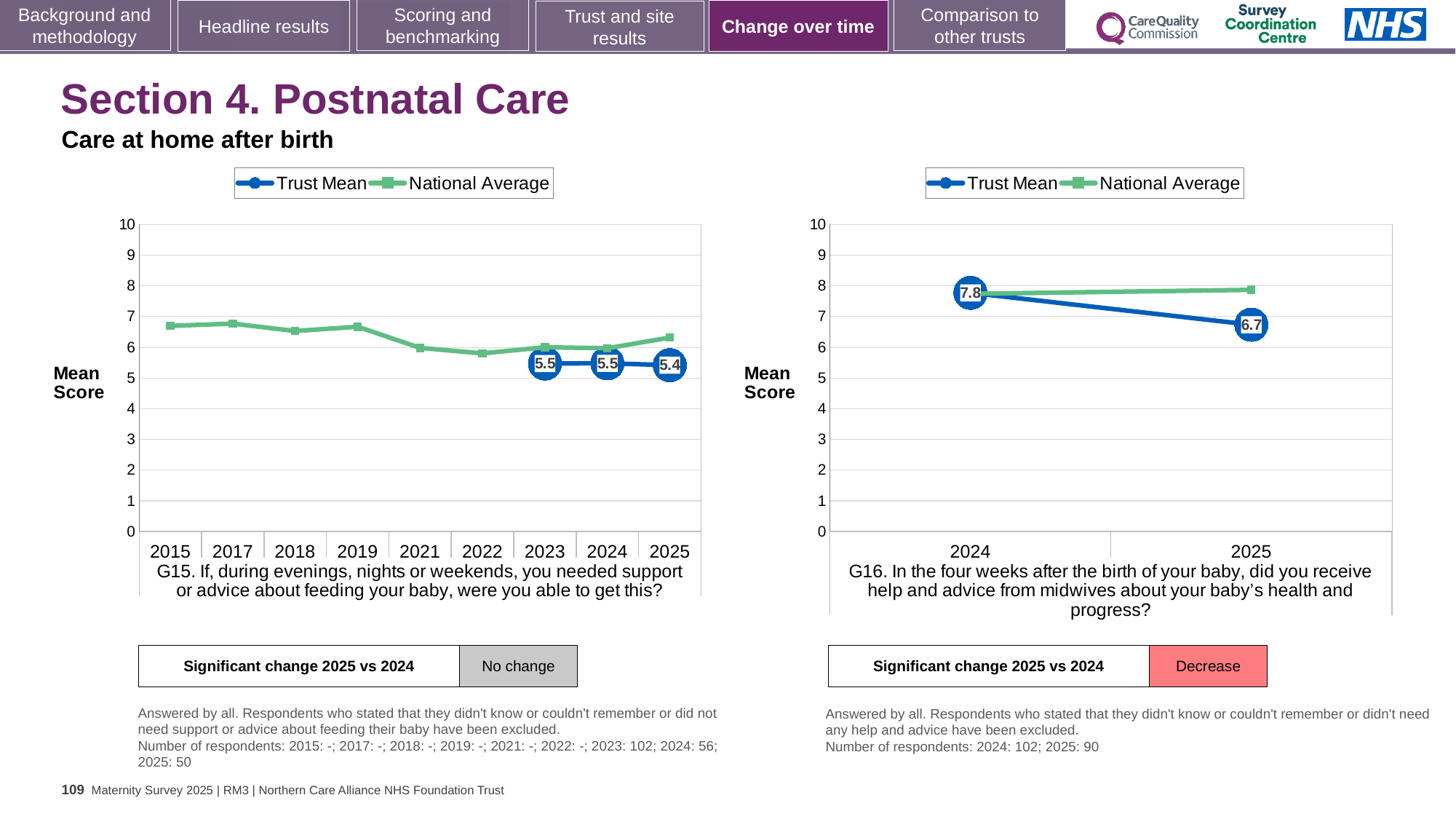
In the G16 chart on the right, by how much did the Trust Mean fall from 2024 to 2025? 1.1 In the G16 chart on the right, how many series does the legend list? 2 In the G16 chart on the right, what is the Trust Mean score for 2024? 7.8 In the G15 chart on the left, is the National Average value for 2015 greater or less than 6? greater In the G16 chart on the right, which series has the higher value in 2025, Trust Mean or National Average? National Average In the G15 chart on the left, what is the Trust Mean score for 2023? 5.5 In the G15 chart on the left, how many years are shown on the x axis? 9 What type of chart is the G15 chart on the left? line chart In the G16 chart on the right, does the Trust Mean rise or fall from 2024 to 2025? fall In the G15 chart on the left, which year has the lowest Trust Mean score among the labelled years? 2025 In the G15 chart on the left, what is the Trust Mean score for 2025? 5.4 In the G16 chart on the right, what is the Trust Mean score for 2025? 6.7